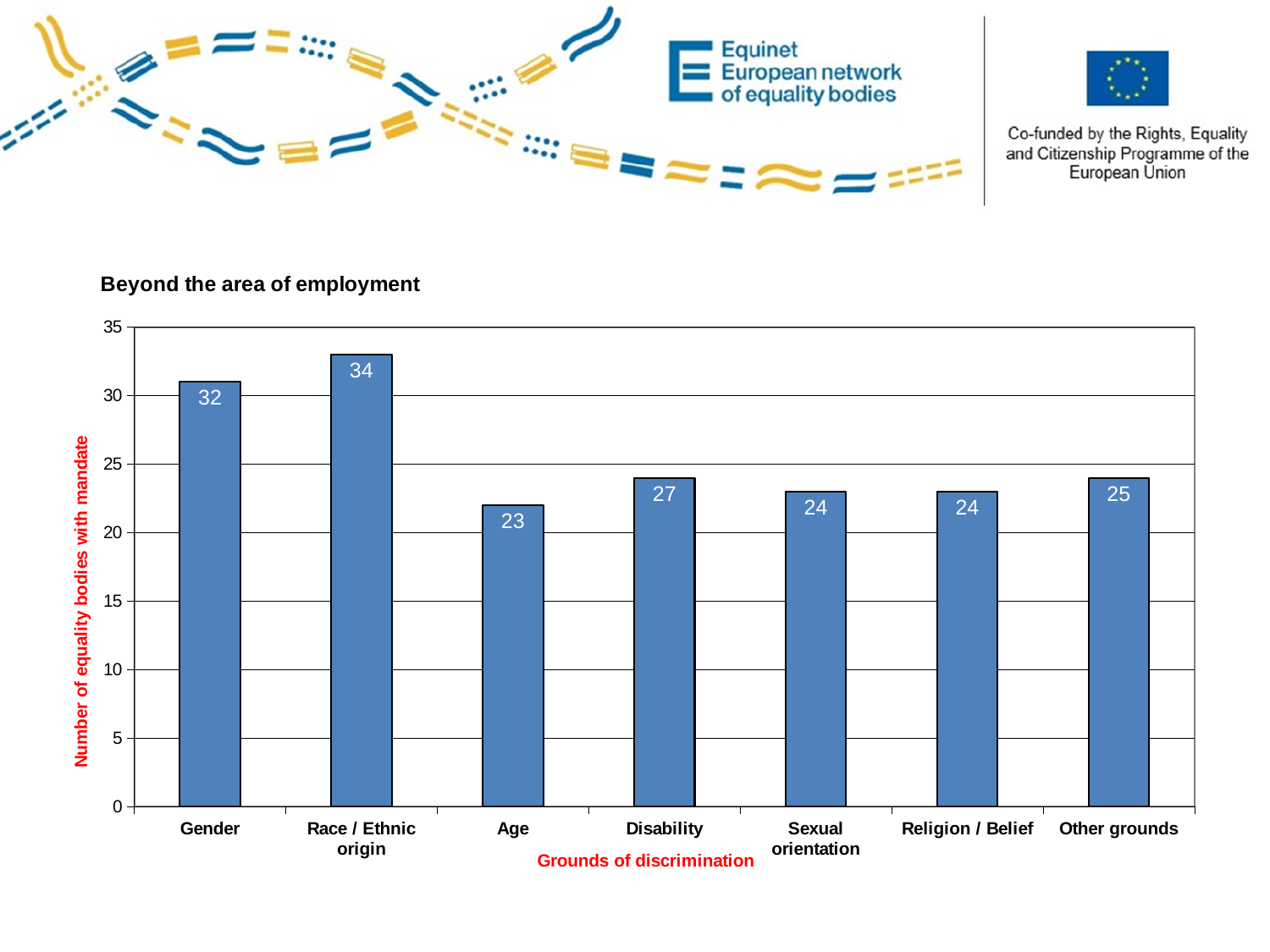
How many grounds of discrimination are shown on the x axis? 7 Which ground of discrimination has the lowest number of equality bodies with mandate? Age What is the title of the chart? Beyond the area of employment Which has a higher value, Disability or Sexual orientation? Disability What is the number of equality bodies with mandate for Disability? 27 What is the difference between the values for Gender and Disability? 5 What kind of chart is shown on the slide? bar chart What is the number of equality bodies with mandate for Gender? 32 What is the value shown for Other grounds? 25 Is the value for Religion / Belief greater or less than 25? less What is the difference between the values for Race / Ethnic origin and Age? 11 Which ground of discrimination has the highest number of equality bodies with mandate? Race / Ethnic origin